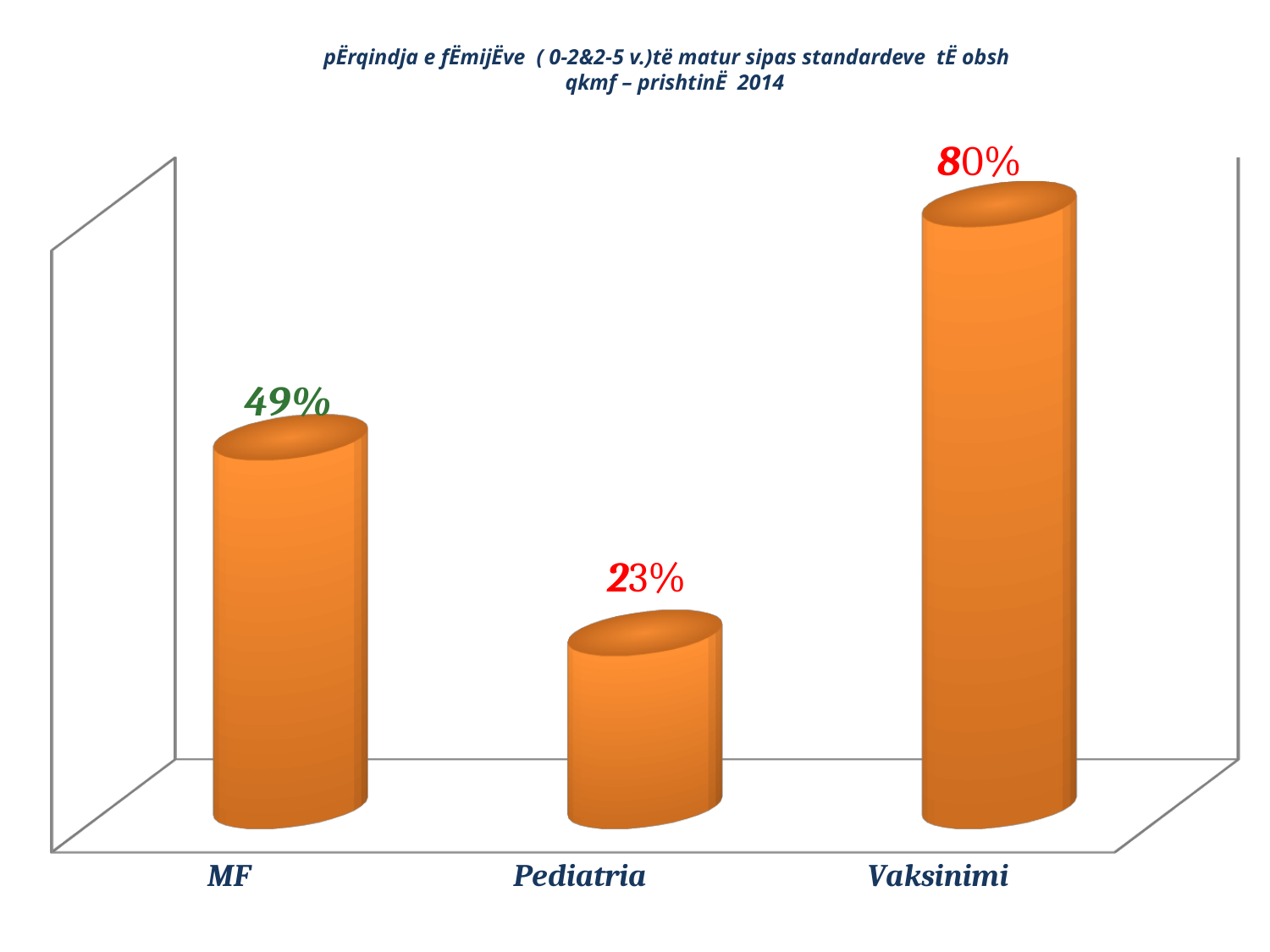
Which category has the lowest value? Pediatria Which is larger, the value for MF or the value for Pediatria? MF What colour are the bars in the chart? Orange What is the difference between the values for Vaksinimi and MF? 31% Which category has the highest value? Vaksinimi What kind of chart is shown on the slide? Bar chart Which year is mentioned in the chart title? 2014 How many categories are shown in the chart? 3 What is the value for Pediatria? 23% What is the difference between the values for MF and Pediatria? 26% What is the value for MF? 49% What is the value for Vaksinimi? 80%